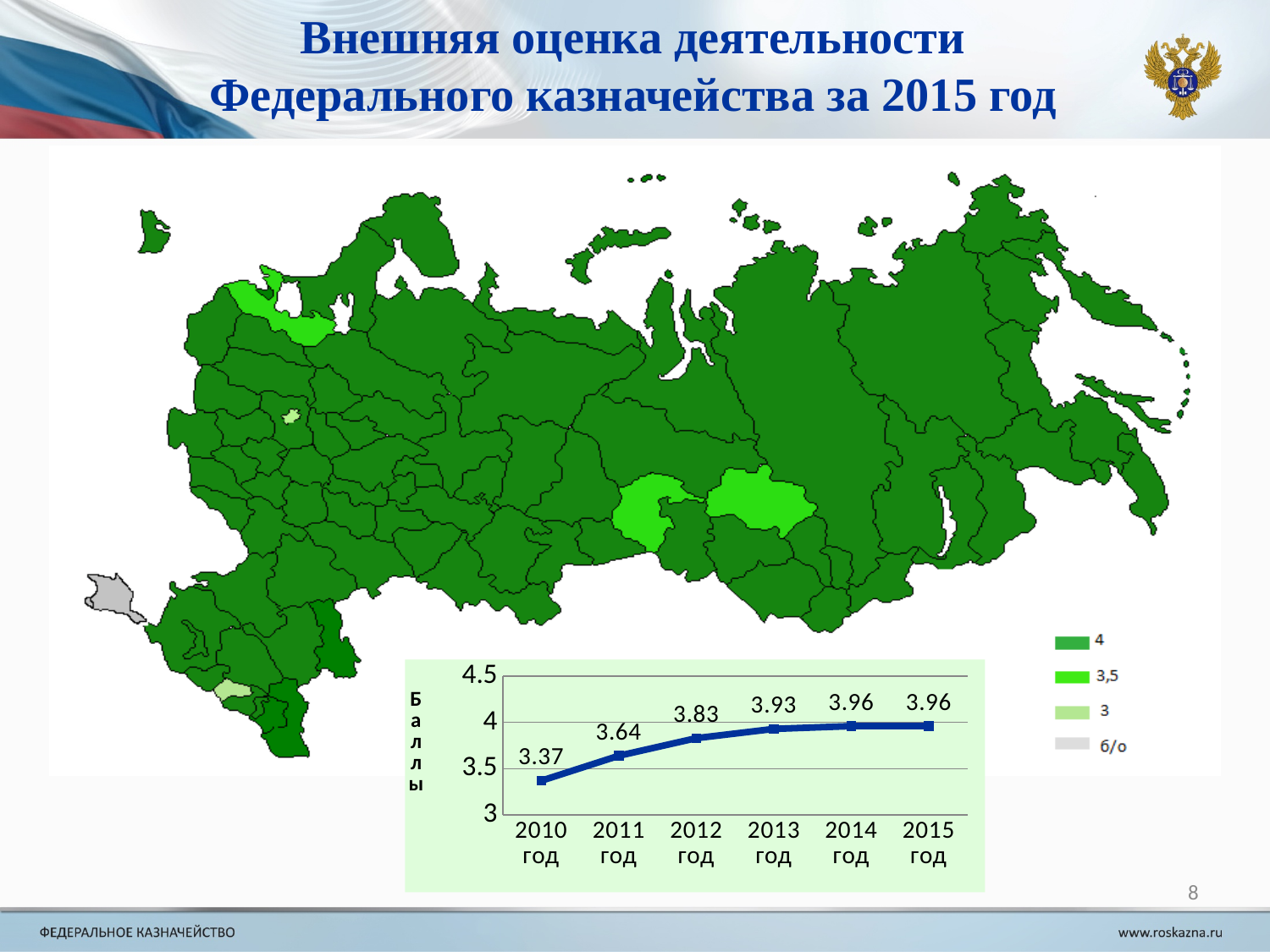
Is the value for 2010 год on the line chart greater or less than 3.5? less What kind of chart is shown at the bottom of the slide? line chart What is the difference between the values for 2012 год and 2011 год on the line chart? 0.19 What is the value for 2013 год on the line chart? 3.93 Which year has the lowest value on the line chart? 2010 год Which is larger on the line chart, the value for 2012 год or 2013 год? 2013 год What is the label on the vertical axis of the line chart? Баллы Do the values on the line chart rise or fall from 2010 год to 2015 год? rise What is the value for 2015 год on the line chart? 3.96 What is the difference between the values for 2015 год and 2010 год on the line chart? 0.59 How many years are plotted on the line chart? 6 What is the value for 2010 год on the line chart? 3.37